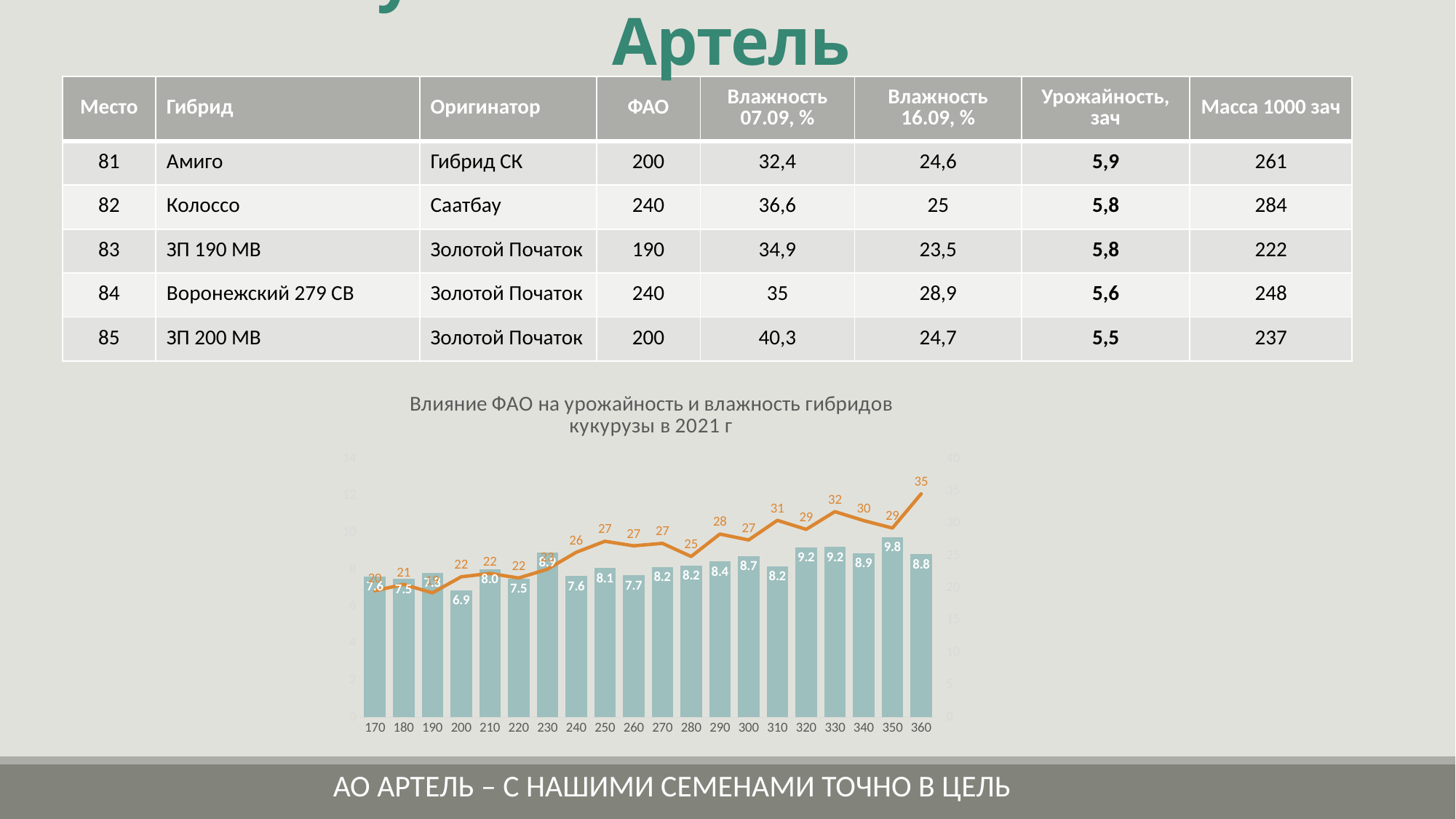
How many ФАО categories are shown on the x axis of the chart 'Влияние ФАО на урожайность и влажность гибридов кукурузы в 2021 г'? 20 In the chart 'Влияние ФАО на урожайность и влажность гибридов кукурузы в 2021 г', which ФАО category has the highest bar? 350 In the chart 'Влияние ФАО на урожайность и влажность гибридов кукурузы в 2021 г', what is the line value at ФАО 280? 25 In the chart 'Влияние ФАО на урожайность и влажность гибридов кукурузы в 2021 г', what is the line value at ФАО 360? 35 What kind of chart is 'Влияние ФАО на урожайность и влажность гибридов кукурузы в 2021 г'? A bar chart combined with a line In the chart 'Влияние ФАО на урожайность и влажность гибридов кукурузы в 2021 г', what is the bar value for ФАО 350? 9.8 In the chart 'Влияние ФАО на урожайность и влажность гибридов кукурузы в 2021 г', which has the larger bar value: ФАО 320 or ФАО 300? 320 In the chart 'Влияние ФАО на урожайность и влажность гибридов кукурузы в 2021 г', what is the line value at ФАО 170? 20 In the chart 'Влияние ФАО на урожайность и влажность гибридов кукурузы в 2021 г', does the line generally rise or fall as ФАО increases from 170 to 360? Rise In the chart 'Влияние ФАО на урожайность и влажность гибридов кукурузы в 2021 г', what is the difference between the bar values for ФАО 350 and ФАО 200? 2.9 In the chart 'Влияние ФАО на урожайность и влажность гибридов кукурузы в 2021 г', which ФАО category has the lowest bar? 200 In the chart 'Влияние ФАО на урожайность и влажность гибридов кукурузы в 2021 г', what is the bar value for ФАО 200? 6.9